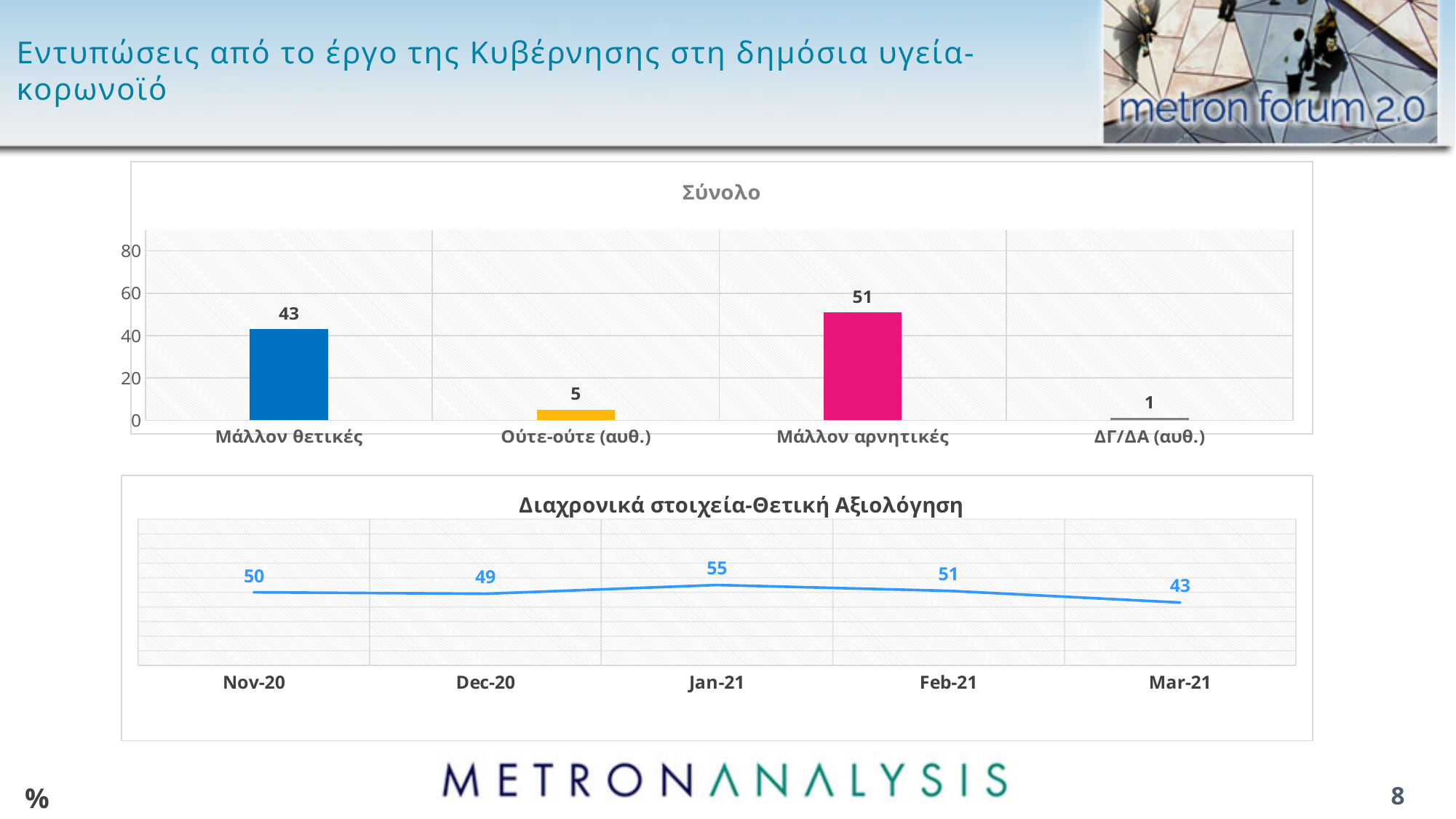
In the 'Σύνολο' chart, which category has the lowest value? ΔΓ/ΔΑ (αυθ.) In the 'Σύνολο' chart, what is the value for 'Ούτε-ούτε (αυθ.)'? 5 In the 'Διαχρονικά στοιχεία-Θετική Αξιολόγηση' chart, which month has the lowest value? Mar-21 In the 'Διαχρονικά στοιχεία-Θετική Αξιολόγηση' chart, how many data points are plotted? 5 In the 'Σύνολο' chart, what is the difference between 'Μάλλον αρνητικές' and 'Μάλλον θετικές'? 8 What kind of chart is the 'Διαχρονικά στοιχεία-Θετική Αξιολόγηση' chart? Line chart In the 'Διαχρονικά στοιχεία-Θετική Αξιολόγηση' chart, what is the value for Jan-21? 55 In the 'Σύνολο' chart, how many categories are shown? 4 In the 'Διαχρονικά στοιχεία-Θετική Αξιολόγηση' chart, what is the difference between Jan-21 and Mar-21? 12 In the 'Σύνολο' chart, what is the value for 'Μάλλον θετικές'? 43 In the 'Σύνολο' chart, which category has the highest value? Μάλλον αρνητικές What kind of chart is the 'Σύνολο' chart? Bar chart